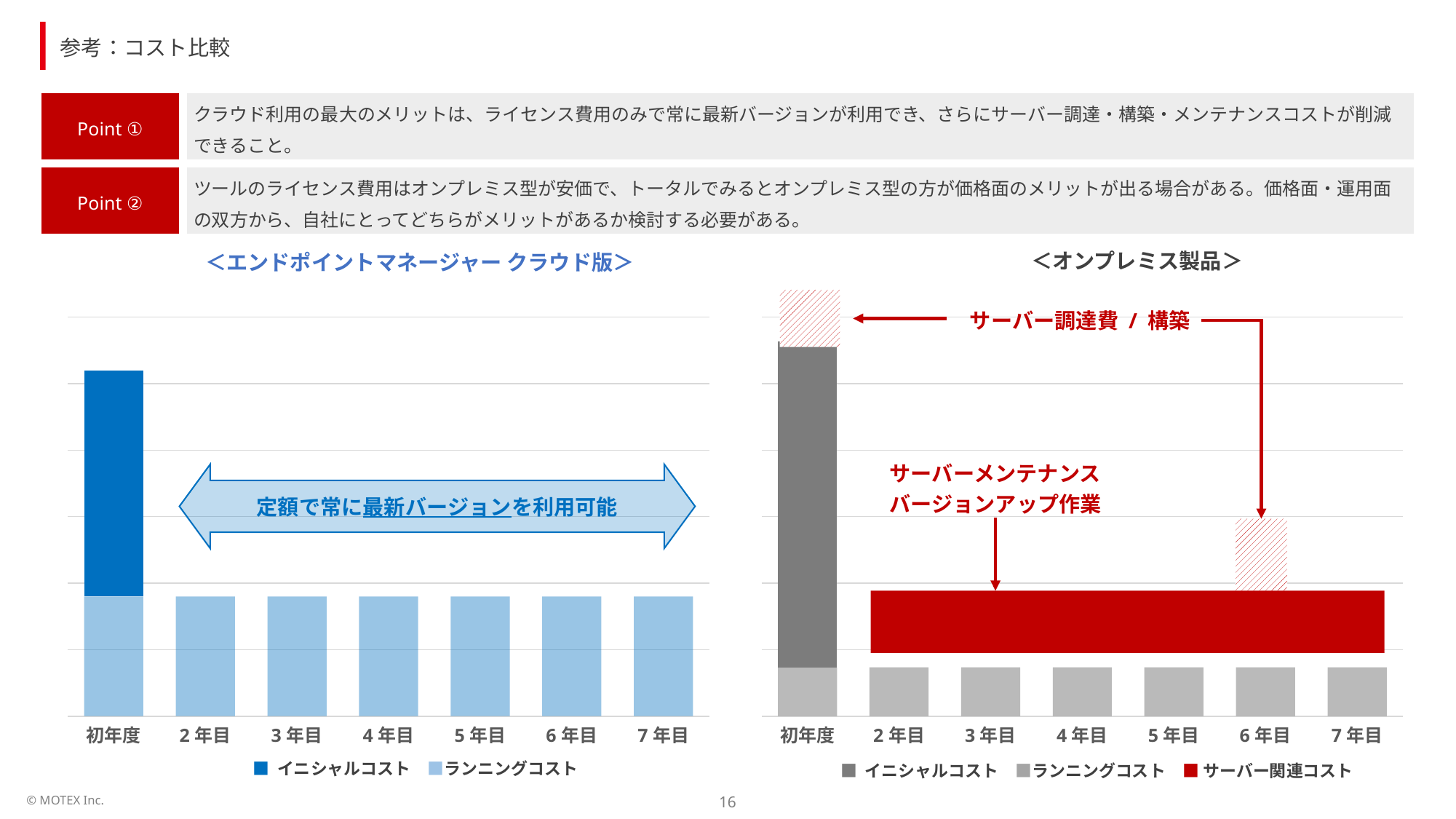
In the <エンドポイントマネージャー クラウド版> chart, which year has the tallest bar? 初年度 How many series does the legend of the <オンプレミス製品> chart list? 3 How many categories are shown on the x axis of the <エンドポイントマネージャー クラウド版> chart? 7 What kind of chart is the <オンプレミス製品> chart? bar chart In the <オンプレミス製品> chart, which year has the tallest bar? 初年度 In the <オンプレミス製品> chart, what is the name of the series shown in red? サーバー関連コスト How many categories are shown on the x axis of the <オンプレミス製品> chart? 7 How many series does the legend of the <エンドポイントマネージャー クラウド版> chart list? 2 In the <オンプレミス製品> chart, which is larger in 初年度: イニシャルコスト or ランニングコスト? イニシャルコスト What kind of chart is the <エンドポイントマネージャー クラウド版> chart? bar chart In the <エンドポイントマネージャー クラウド版> chart, do the ランニングコスト bars rise, fall, or stay flat from 2年目 to 7年目? stay flat In the <エンドポイントマネージャー クラウド版> chart, which series appears only in the 初年度 bar? イニシャルコスト